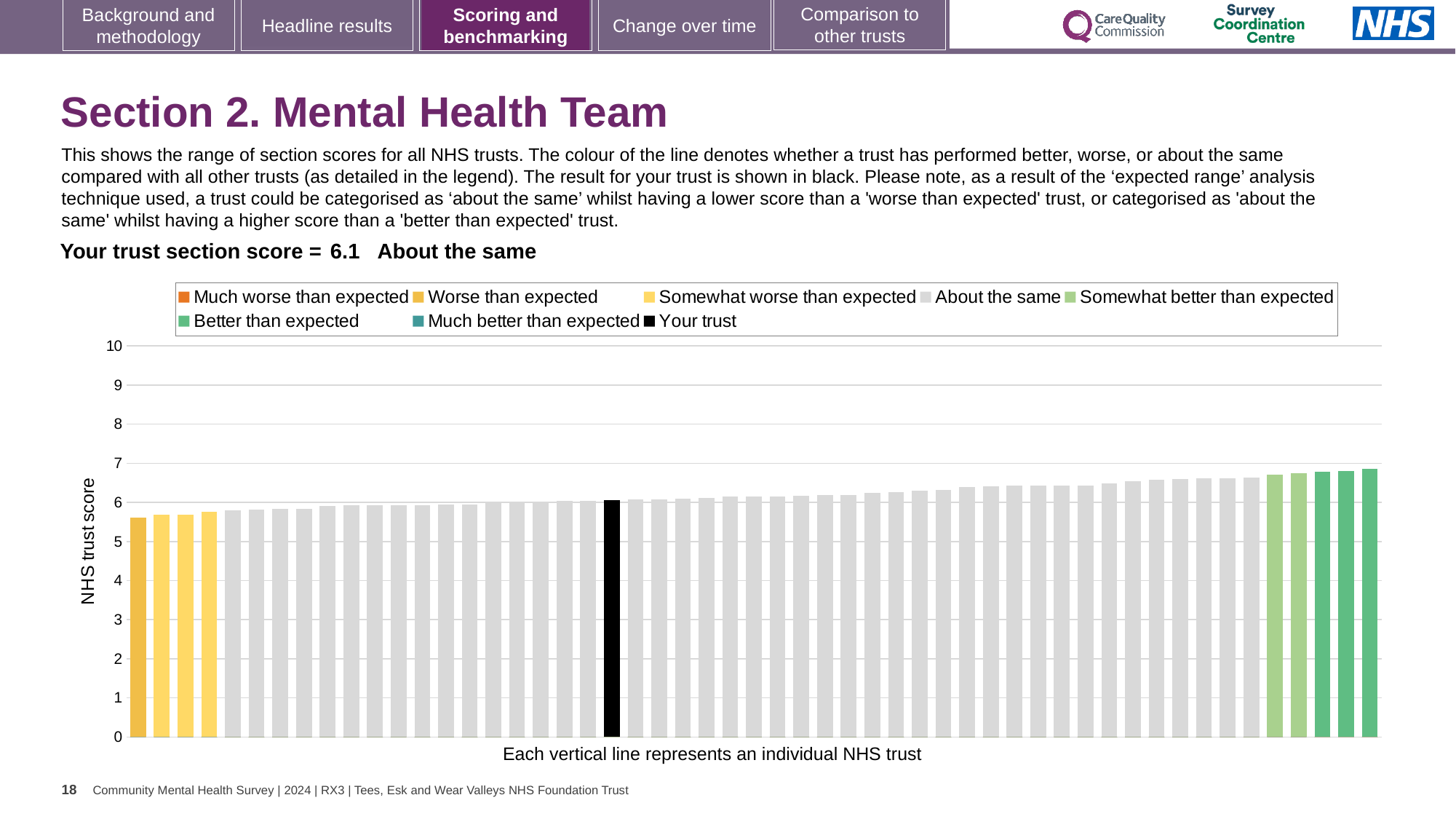
What kind of chart is shown on the slide? bar chart What is the label on the vertical axis of the chart? NHS trust score Do the bar values rise or fall moving from left to right along the x axis? rise Is the value of the black bar (your trust) greater or less than 5? greater Is the value of the highest bar on the chart greater or less than 6? greater Which category is your trust placed in for this section? About the same Is the value of the lowest bar on the chart greater or less than 6? less How many bars are shown in yellow shades (the worse-than-expected categories)? 4 How many entries does the chart legend list? 8 What colour is the bar representing your trust? black What is the section score for your trust shown on the slide? 6.1